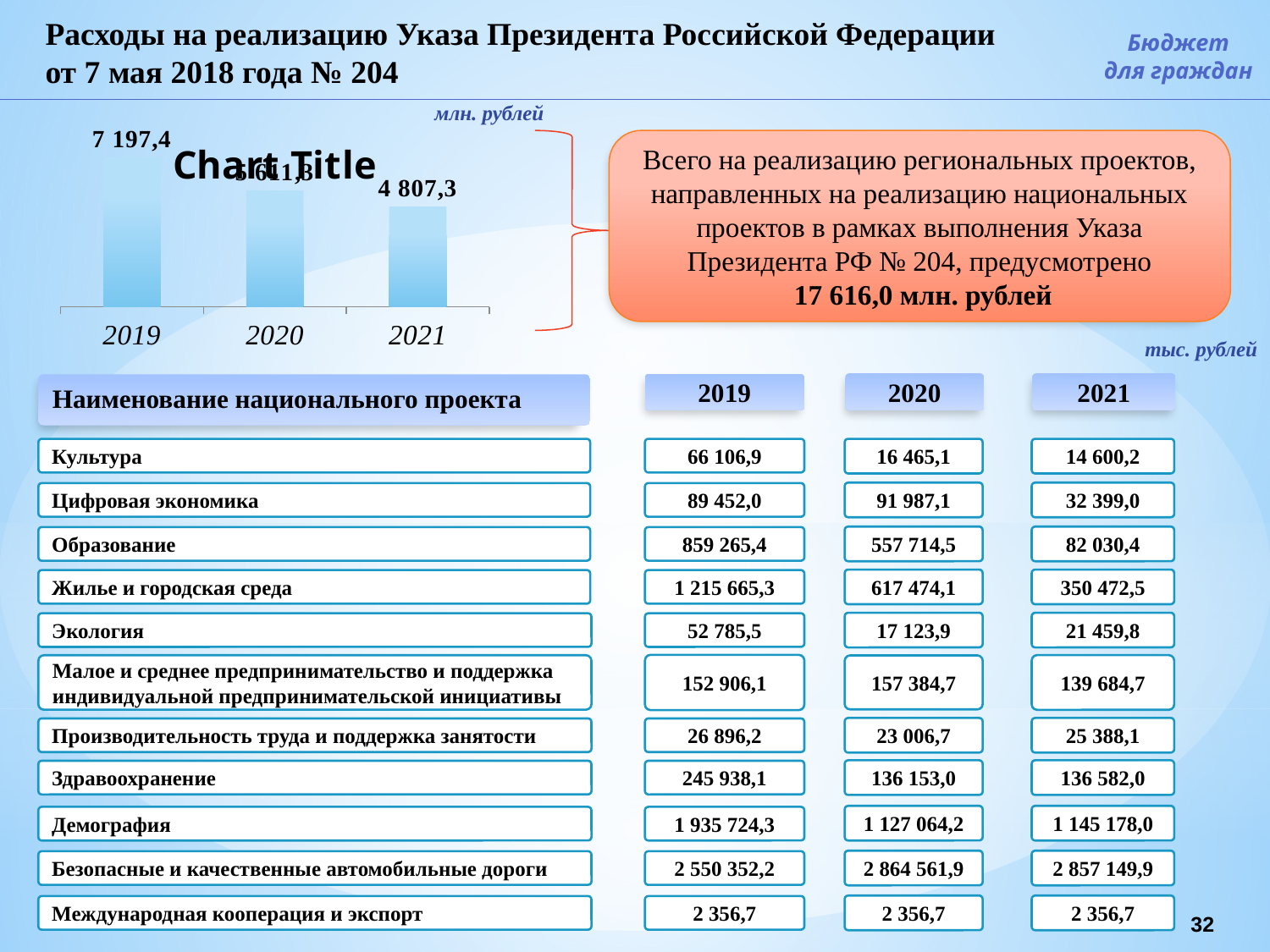
Do the values in the bar chart rise or fall from 2019 to 2021? Fall What unit is indicated above the bar chart? млн. рублей How many years are shown on the x axis of the bar chart? 3 What is the value for 2021 in the bar chart? 4 807,3 What is the value for 2019 in the bar chart? 7 197,4 What title is displayed on the chart? Chart Title What kind of chart is shown on the slide? Bar chart Which is larger in the bar chart, the value for 2019 or the value for 2021? 2019 Which year has the highest value in the bar chart? 2019 Which is larger in the bar chart, the value for 2020 or the value for 2021? 2020 Which year has the lowest value in the bar chart? 2021 What is the difference between the 2019 and 2021 values in the bar chart? 2 390,1